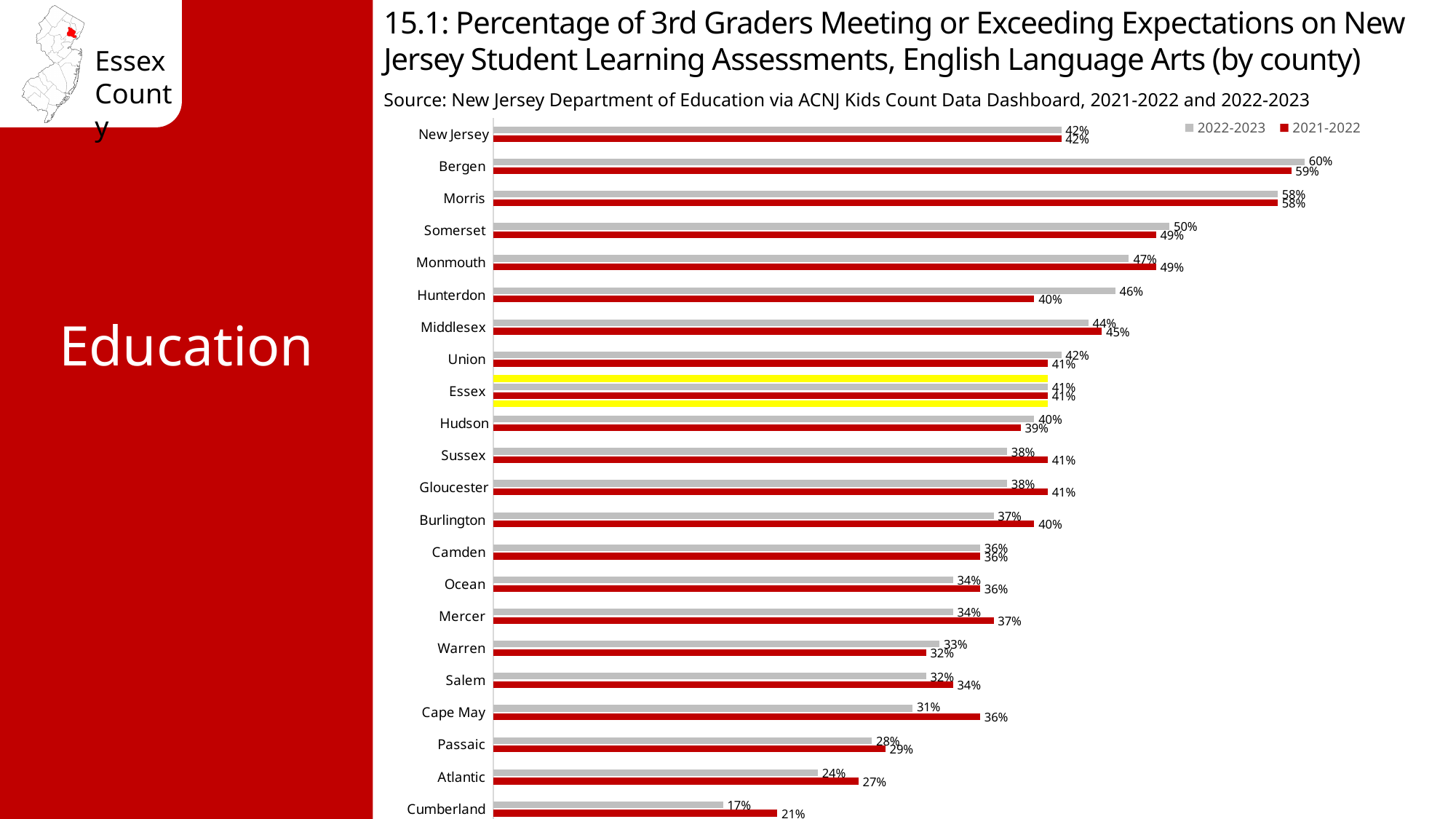
How many series does the legend list? 2 What is the difference between the 2022-2023 and 2021-2022 values for Hunterdon? 6% What is the 2022-2023 value for Cape May? 31% What is the 2022-2023 value for Essex? 41% Which county has the lowest 2021-2022 value? Cumberland Which is larger for Mercer: the 2022-2023 value or the 2021-2022 value? 2021-2022 What is the difference between Bergen's and Cumberland's 2022-2023 values? 43% Which series is shown in red? 2021-2022 What kind of chart is shown on the slide? Bar chart How many counties or regions are listed on the chart? 22 What is the 2021-2022 value for Hunterdon? 40% Which county has the highest 2022-2023 value? Bergen